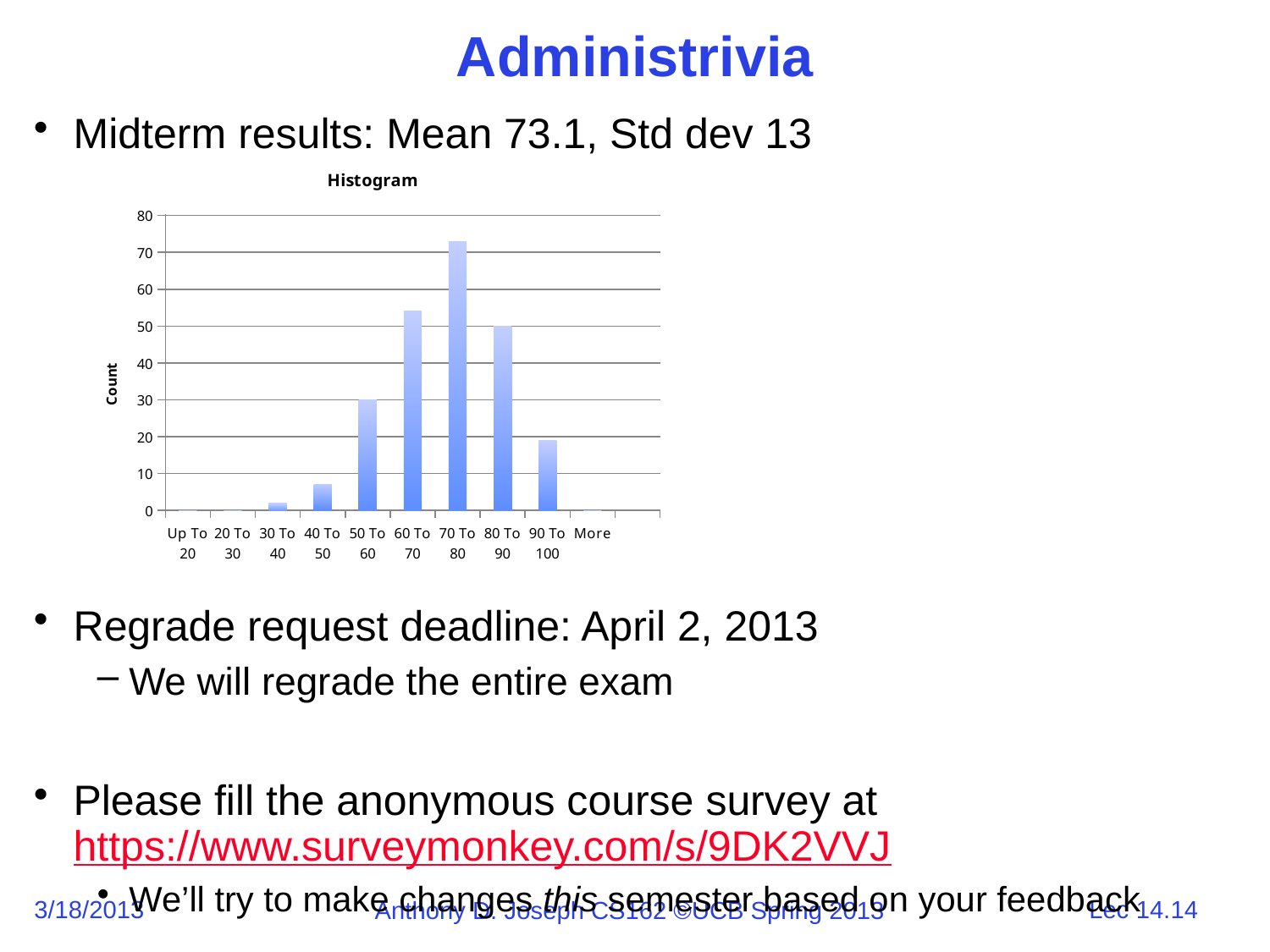
Is the count for the 70 To 80 bin greater or less than 70? greater What is the title of the chart? Histogram What is the count for the 80 To 90 bin? 50 Is the count for the 40 To 50 bin greater or less than 10? less What type of chart is shown on the slide? bar chart Which bin has a higher count, 50 To 60 or 80 To 90? 80 To 90 Which score bin has the tallest bar in the chart? 70 To 80 What is the count for the 50 To 60 bin? 30 How many score bins are shown along the x axis of the chart? 10 What is the label on the vertical axis of the chart? Count Which bin has a higher count, 60 To 70 or 90 To 100? 60 To 70